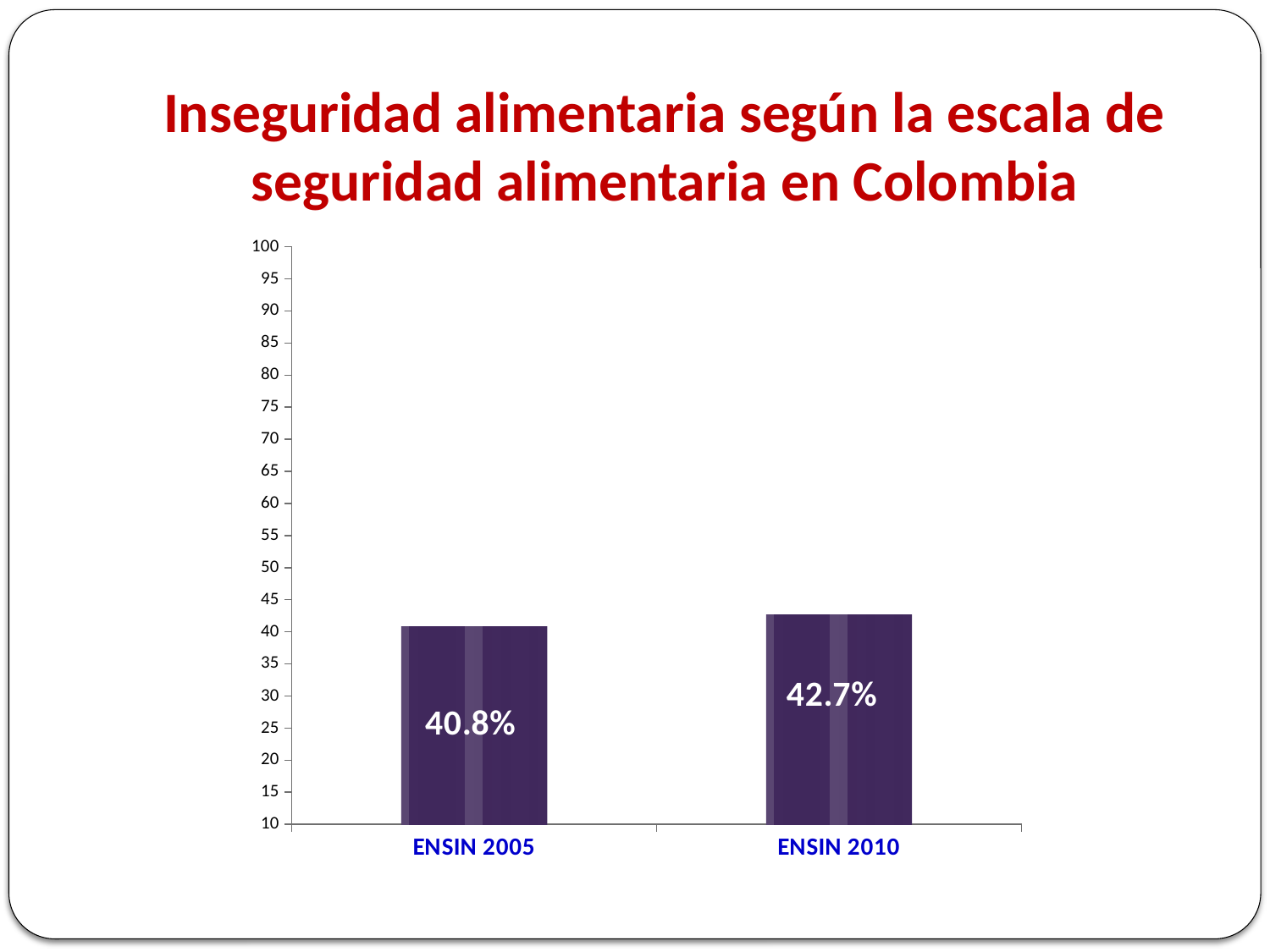
What kind of chart is shown on the slide? bar chart Do the values rise or fall from ENSIN 2005 to ENSIN 2010? rise How many categories are shown on the x axis? 2 What is the difference between the values for ENSIN 2010 and ENSIN 2005? 1.9% Which is larger, the value for ENSIN 2005 or ENSIN 2010? ENSIN 2010 What is the value for ENSIN 2010? 42.7% Is the value for ENSIN 2010 greater or less than 40? greater What is the title of the slide? Inseguridad alimentaria según la escala de seguridad alimentaria en Colombia What is the value for ENSIN 2005? 40.8% Is the value for ENSIN 2005 greater or less than 50? less Which category has the highest value? ENSIN 2010 Which category has the lowest value? ENSIN 2005